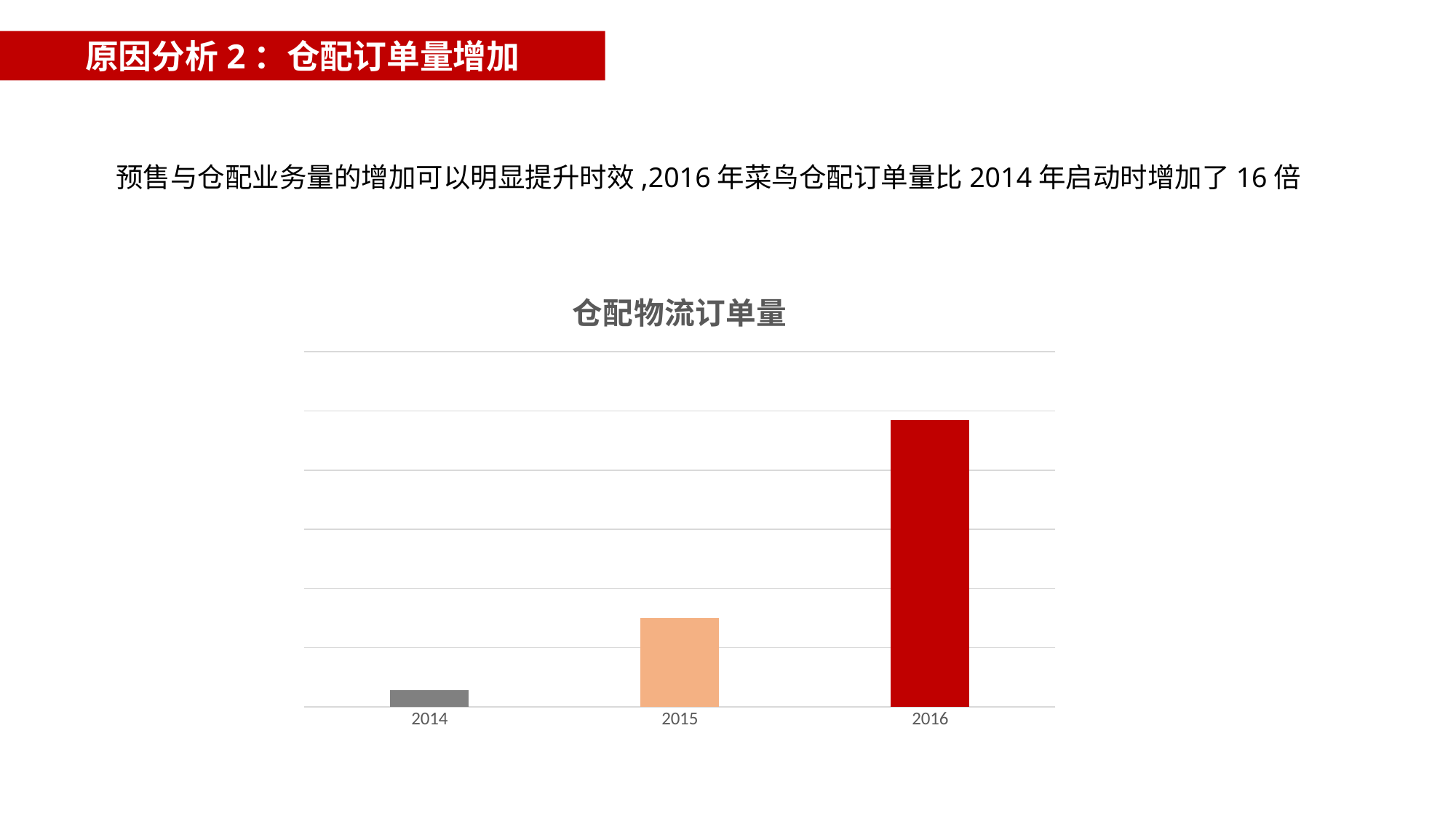
What colour is the bar for 2016? red Which is larger, the value for 2014 or the value for 2015? 2015 What kind of chart is shown on the slide? bar chart Which is larger, the value for 2015 or the value for 2016? 2016 Which years are shown on the x axis of the chart? 2014, 2015, 2016 Do the values rise or fall from 2014 to 2016? rise Which year has the lowest value in the chart? 2014 Which year has the highest value in the chart? 2016 What is the title of the chart? 仓配物流订单量 How many categories are shown on the x axis of the chart? 3